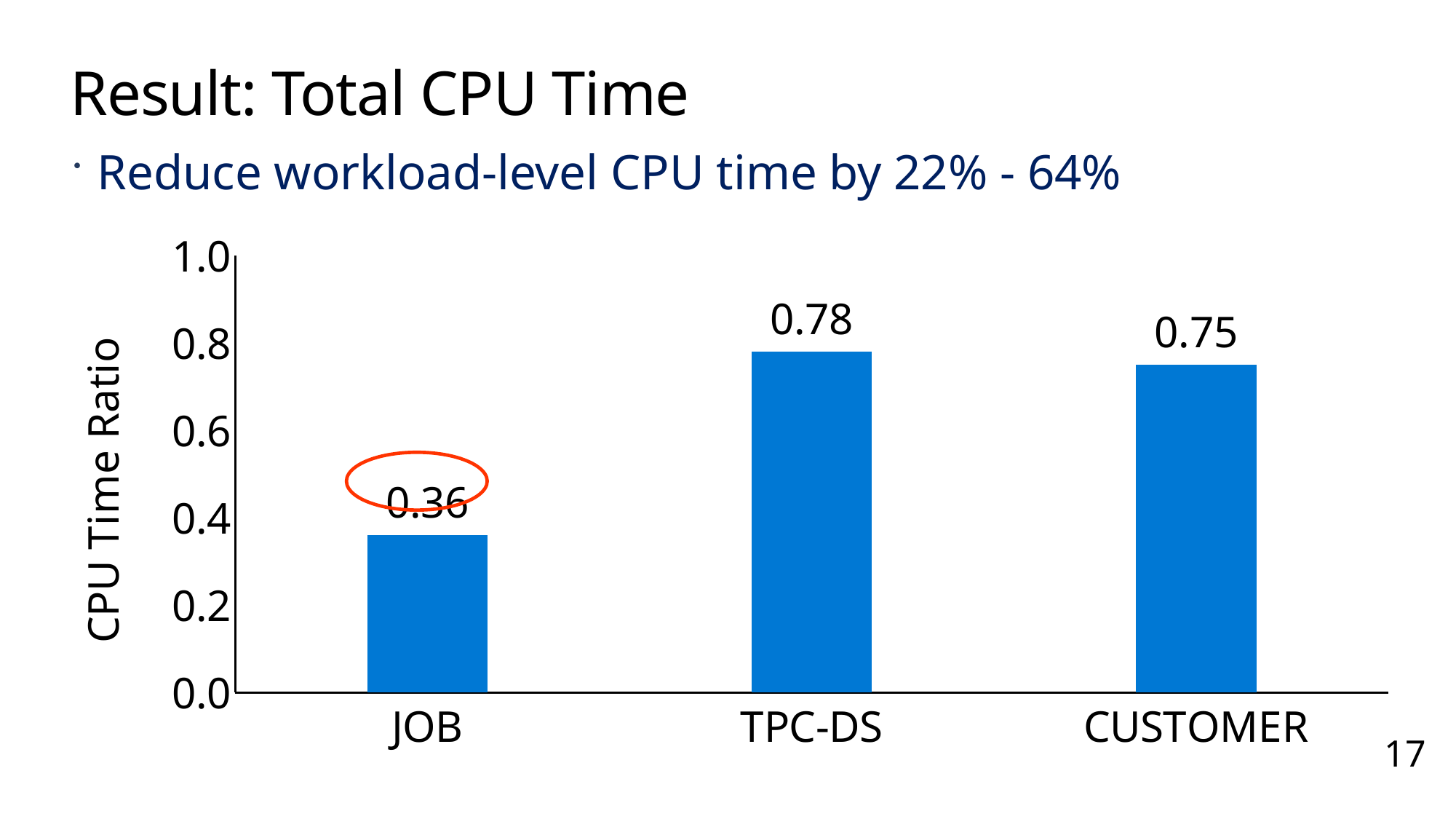
Which has a larger CPU Time Ratio, JOB or CUSTOMER? CUSTOMER What is the label of the y axis of the chart? CPU Time Ratio What is the CPU Time Ratio for JOB? 0.36 What is the CPU Time Ratio for TPC-DS? 0.78 What is the difference between the CPU Time Ratio for TPC-DS and JOB? 0.42 Is the CPU Time Ratio for JOB greater or less than 0.4? less What is the CPU Time Ratio for CUSTOMER? 0.75 What kind of chart is shown on the slide? bar chart Which workload has the highest CPU Time Ratio? TPC-DS How many workloads are shown on the x axis of the chart? 3 What is the difference between the CPU Time Ratio for TPC-DS and CUSTOMER? 0.03 Which workload has the lowest CPU Time Ratio? JOB